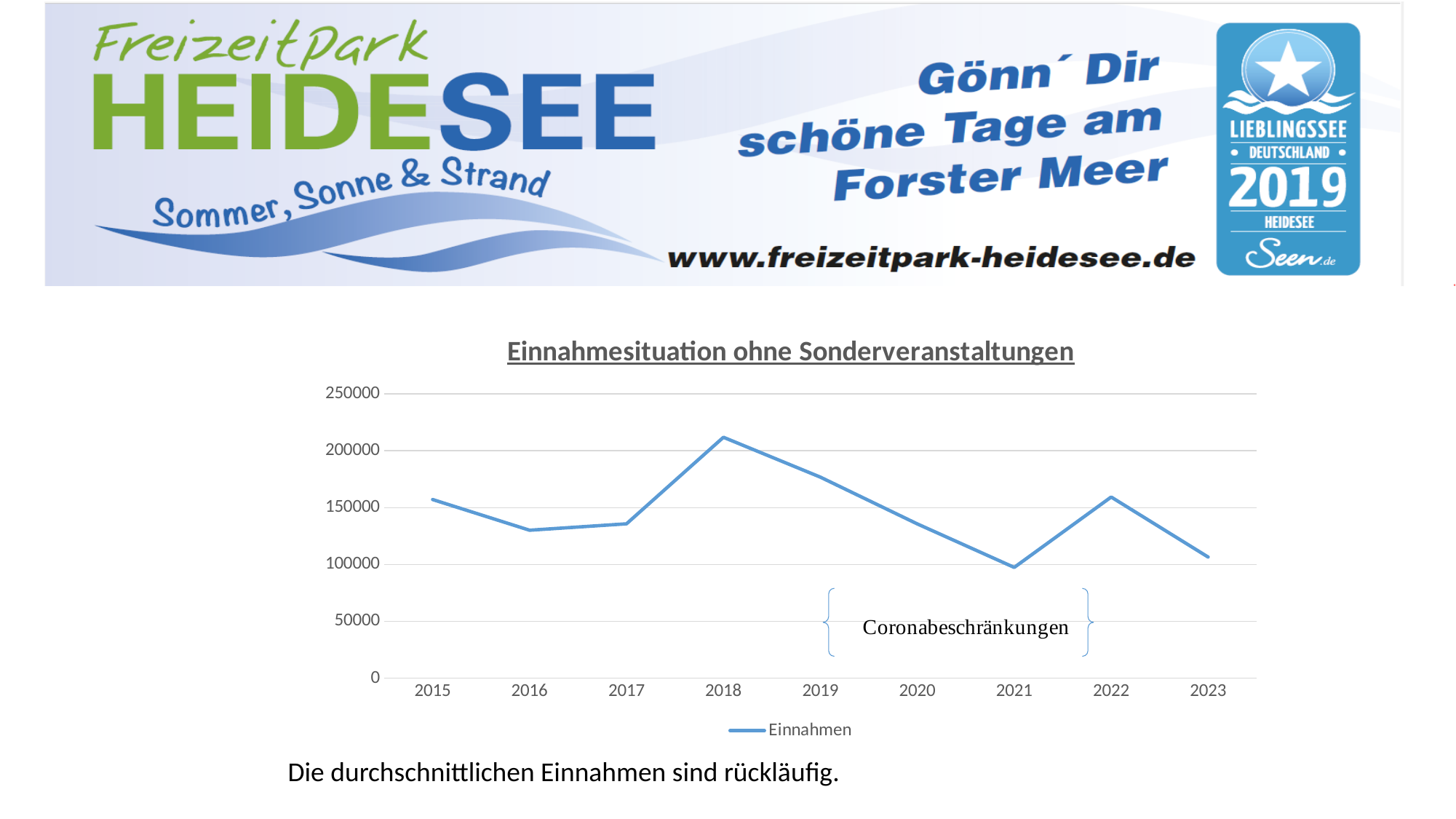
Is the value for 2019 greater or less than 150000? greater Is the value for 2021 greater or less than 150000? less How many years are plotted on the x axis? 9 How many series does the legend list? 1 What kind of chart is shown on the slide? line chart Do the Einnahmen values rise or fall from 2018 to 2021? fall Which year has the lowest Einnahmen value? 2021 What is the name of the series shown in the legend? Einnahmen What is the title of the chart? Einnahmesituation ohne Sonderveranstaltungen Is the value for 2018 greater or less than 200000? greater Which year has the highest Einnahmen value? 2018 Which year has the larger Einnahmen value, 2016 or 2022? 2022